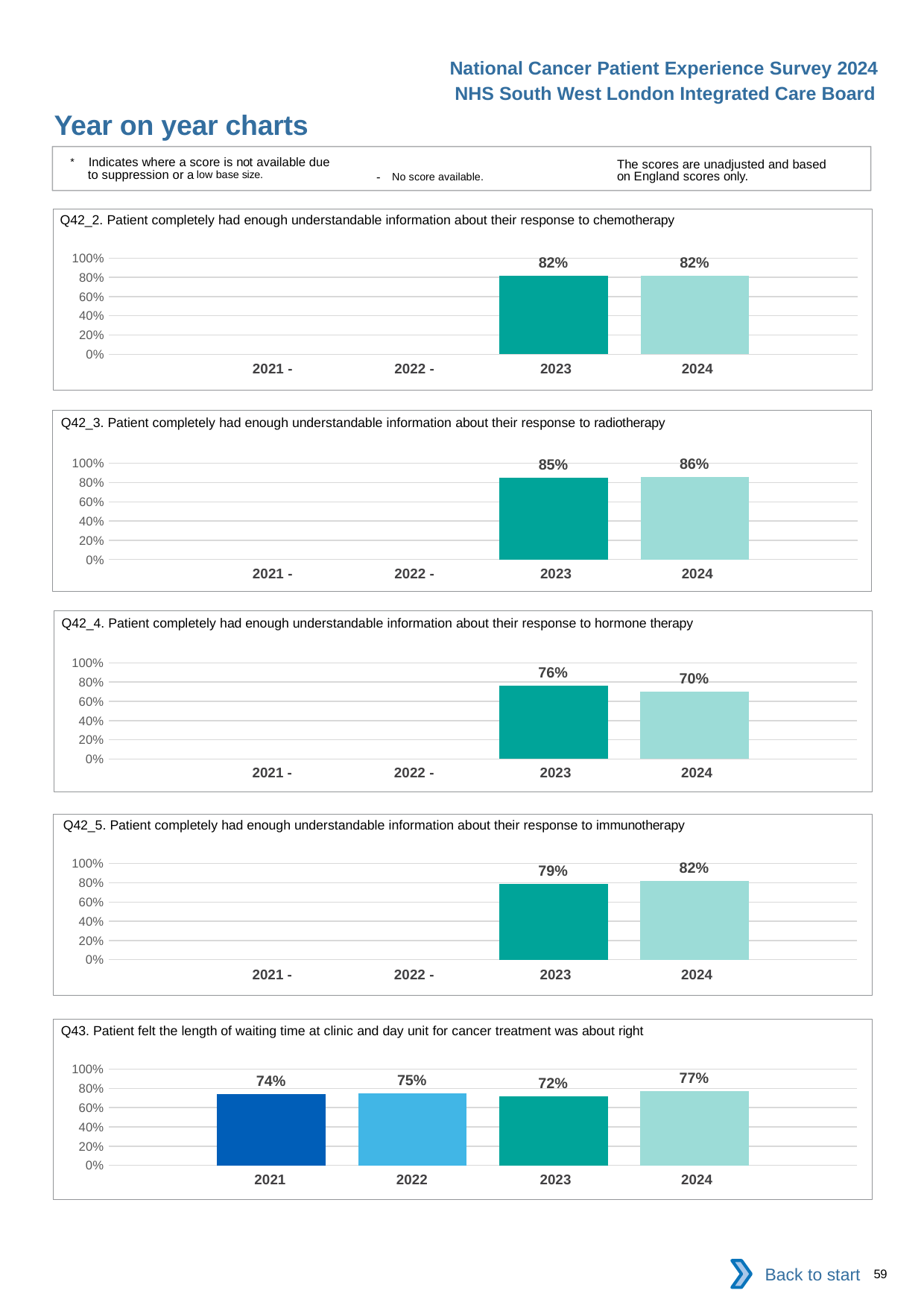
In the Q43 chart (waiting time at clinic and day unit), what is the difference between the 2024 and 2023 values? 5% In the Q43 chart (waiting time at clinic and day unit), which year has the lowest value? 2023 In the Q42_4 chart (hormone therapy), which year has the higher value, 2023 or 2024? 2023 In the Q42_3 chart (radiotherapy), what is the value for 2024? 86% How many bars with values are plotted in the Q43 chart (waiting time at clinic and day unit)? 4 In the Q42_5 chart (immunotherapy), which year has the higher value, 2023 or 2024? 2024 What kind of chart is the Q42_2 chart (chemotherapy)? Bar chart In the Q43 chart (waiting time at clinic and day unit), which year has the highest value? 2024 In the Q42_5 chart (immunotherapy), what is the value for 2023? 79% In the Q42_3 chart (radiotherapy), is the value for 2023 greater or less than 80%? greater In the Q42_2 chart (chemotherapy), what is the value for 2023? 82% In the Q42_4 chart (hormone therapy), what is the difference between the 2023 and 2024 values? 6%